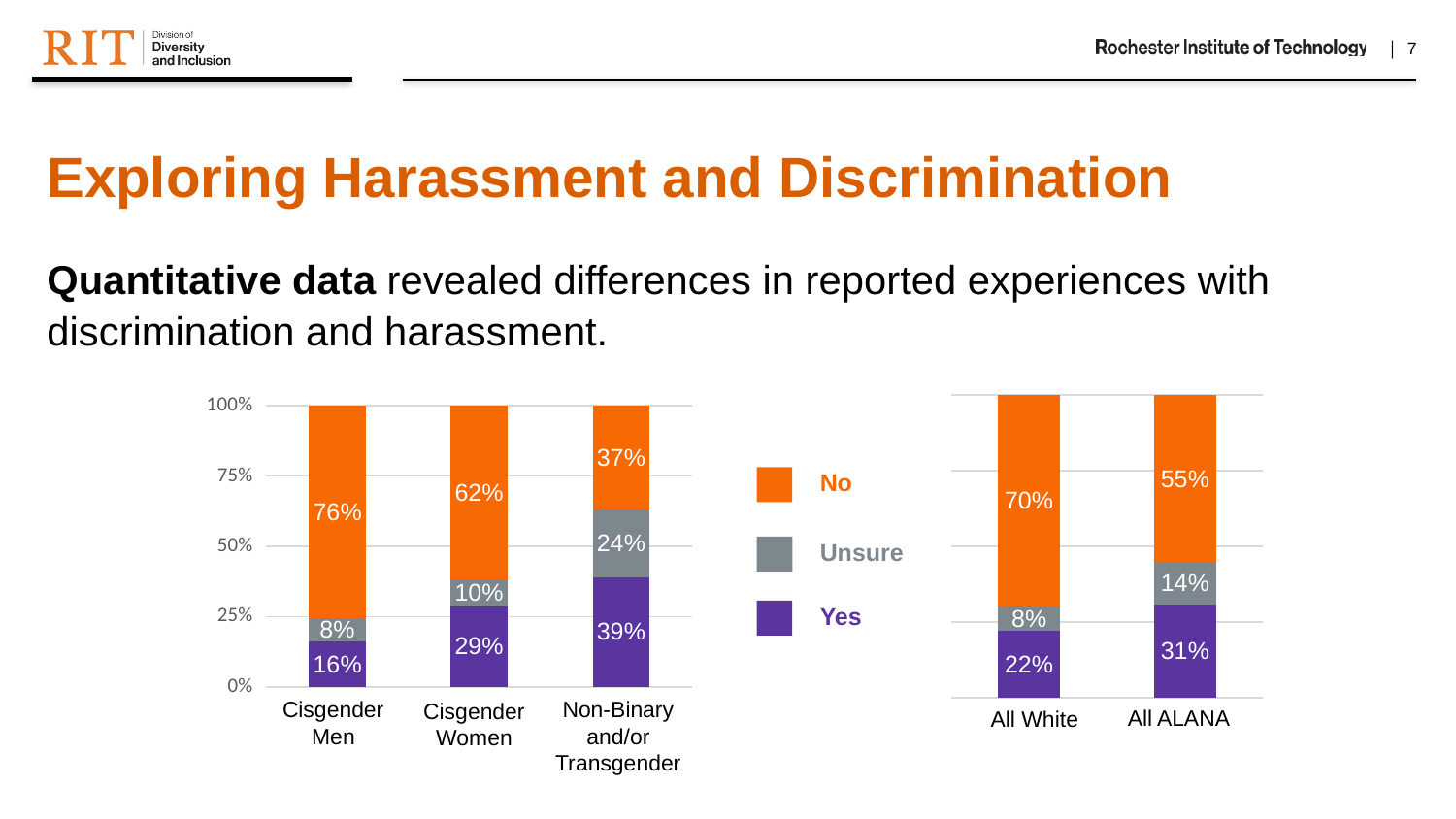
In the right chart, what is the No value for All White respondents? 70% In the left chart, which category has the highest Yes percentage? Non-Binary and/or Transgender In the right chart, what is the difference between the No values for All White and All ALANA? 15% How many categories are shown on the x axis of the left chart? 3 In the left chart, what percentage of Cisgender Men answered No? 76% In the left chart, what percentage of Cisgender Women answered Yes? 29% What type of chart is the right chart? Stacked bar chart In the left chart, which is larger: the Yes value for Cisgender Women or the Yes value for Cisgender Men? Cisgender Women In the left chart, what is the Unsure value for Non-Binary and/or Transgender respondents? 24% In the left chart, which category has the lowest Yes percentage? Cisgender Men How many series does the legend list? 3 In the right chart, what percentage of All ALANA respondents answered Yes? 31%